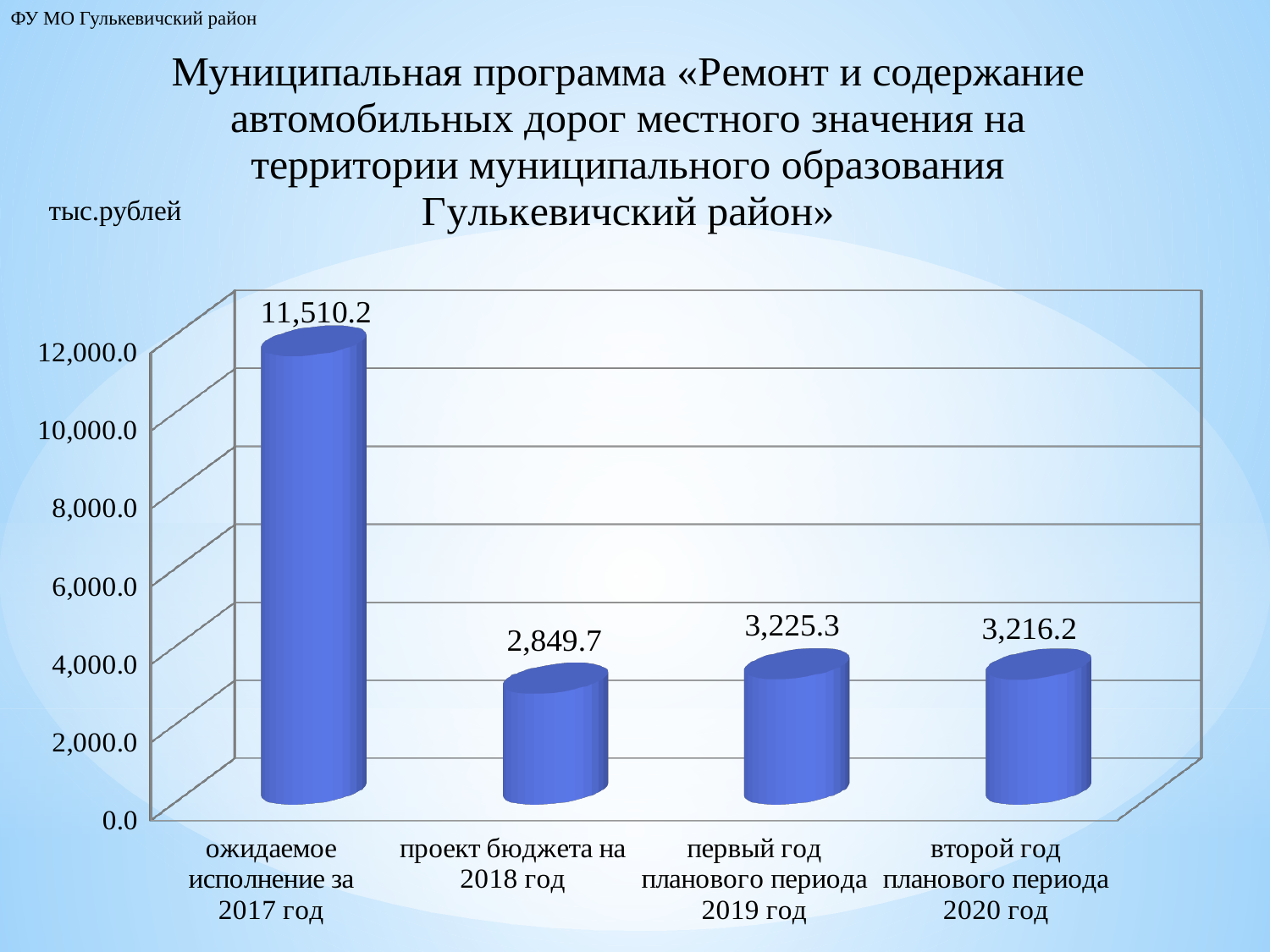
What is the difference between the value for 2017 and the value for 2018? 8,660.5 What is the difference between the value for 2019 and the value for 2020? 9.1 What kind of chart is shown on the slide? bar chart What is the value for «первый год планового периода 2019 год»? 3,225.3 Which category has the highest value? ожидаемое исполнение за 2017 год Is the value for «проект бюджета на 2018 год» greater or less than 4,000.0? less How many categories are shown on the chart? 4 What is the value for «ожидаемое исполнение за 2017 год»? 11,510.2 Which category has the lowest value? проект бюджета на 2018 год What is the value for «проект бюджета на 2018 год»? 2,849.7 Which is larger, the value for 2019 or the value for 2020? 2019 What is the value for «второй год планового периода 2020 год»? 3,216.2